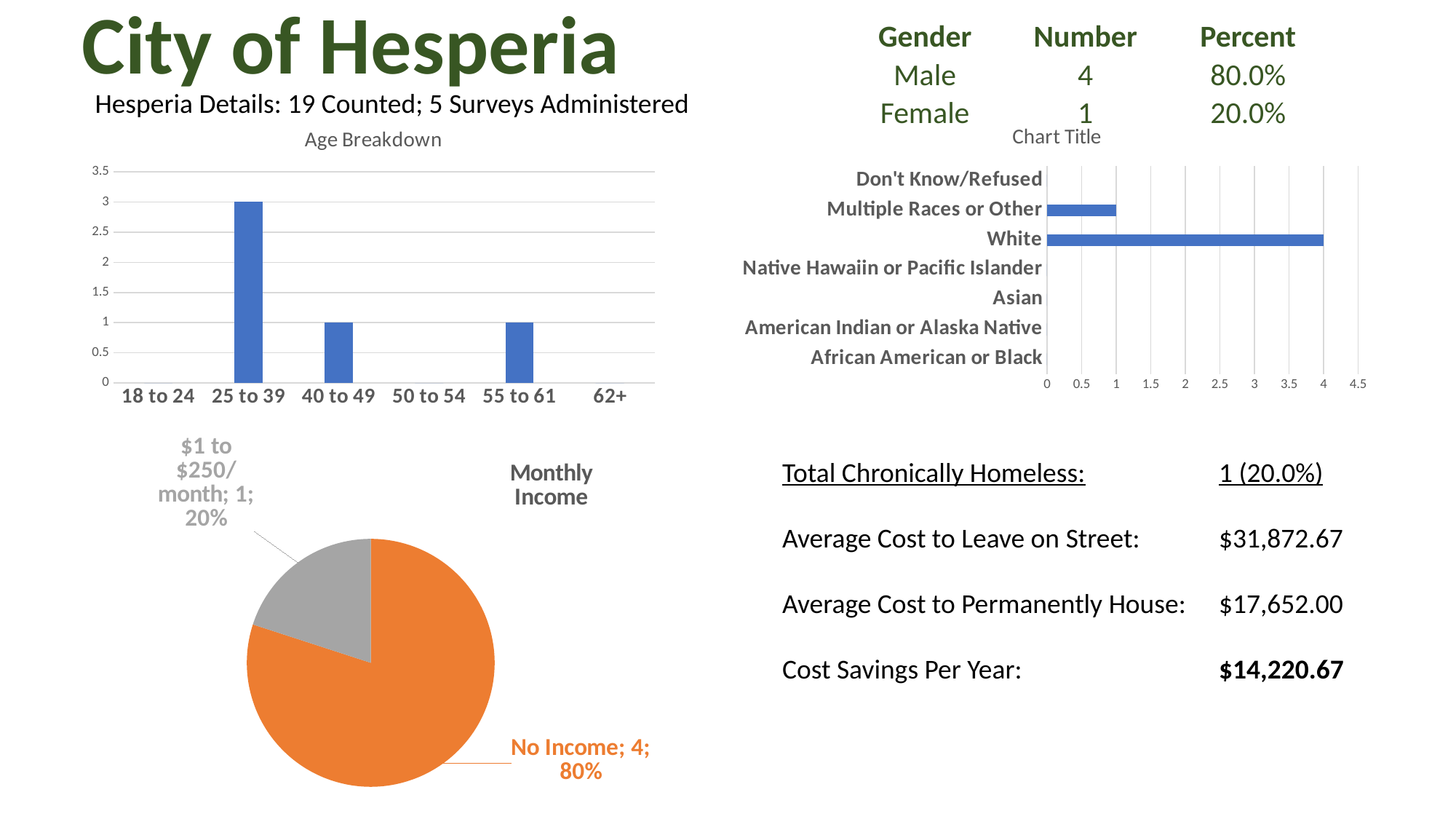
In the Age Breakdown chart, what is the difference between the values for 25 to 39 and 40 to 49? 2 In the race chart on the right (titled 'Chart Title'), what is the value for Multiple Races or Other? 1 What kind of chart is the Age Breakdown chart? bar chart In the race chart on the right (titled 'Chart Title'), which category has the highest value? White In the race chart on the right (titled 'Chart Title'), what is the value for White? 4 In the Monthly Income pie chart, what share does the No Income slice represent? 80% In the Age Breakdown chart, what is the value for the 25 to 39 age group? 3 In the Monthly Income pie chart, how many people are in the $1 to $250/month category? 1 In the Age Breakdown chart, how many age categories are shown on the x axis? 6 In the Monthly Income pie chart, which slice is larger: No Income or $1 to $250/month? No Income In the Age Breakdown chart, which age group has the highest value? 25 to 39 In the race chart on the right (titled 'Chart Title'), how many categories are listed on the vertical axis? 7